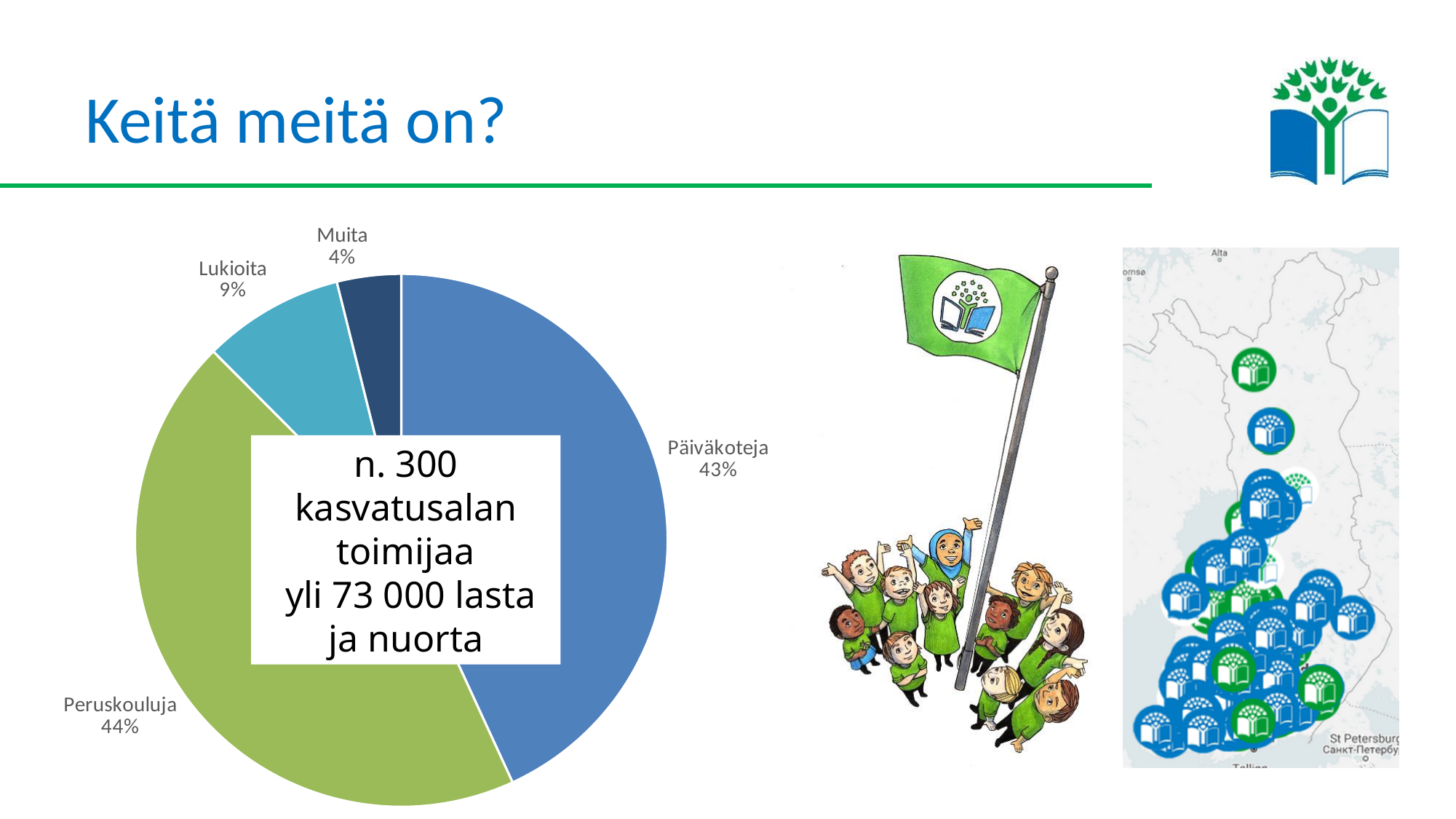
What share of the pie does Päiväkoteja have? 43% What kind of chart is shown on the slide? pie chart What share of the pie does Muita have? 4% What is the difference in percentage points between the Peruskouluja and Lukioita slices? 35 Which category has the largest slice of the pie? Peruskouluja What is the combined share of the Lukioita and Muita slices? 13% Which is larger, the share for Lukioita or the share for Muita? Lukioita What share of the pie does Peruskouluja have? 44% What share of the pie does Lukioita have? 9% What text is written in the centre of the pie chart? n. 300 kasvatusalan toimijaa yli 73 000 lasta ja nuorta Which category has the smallest slice of the pie? Muita How many slices does the pie chart have? 4